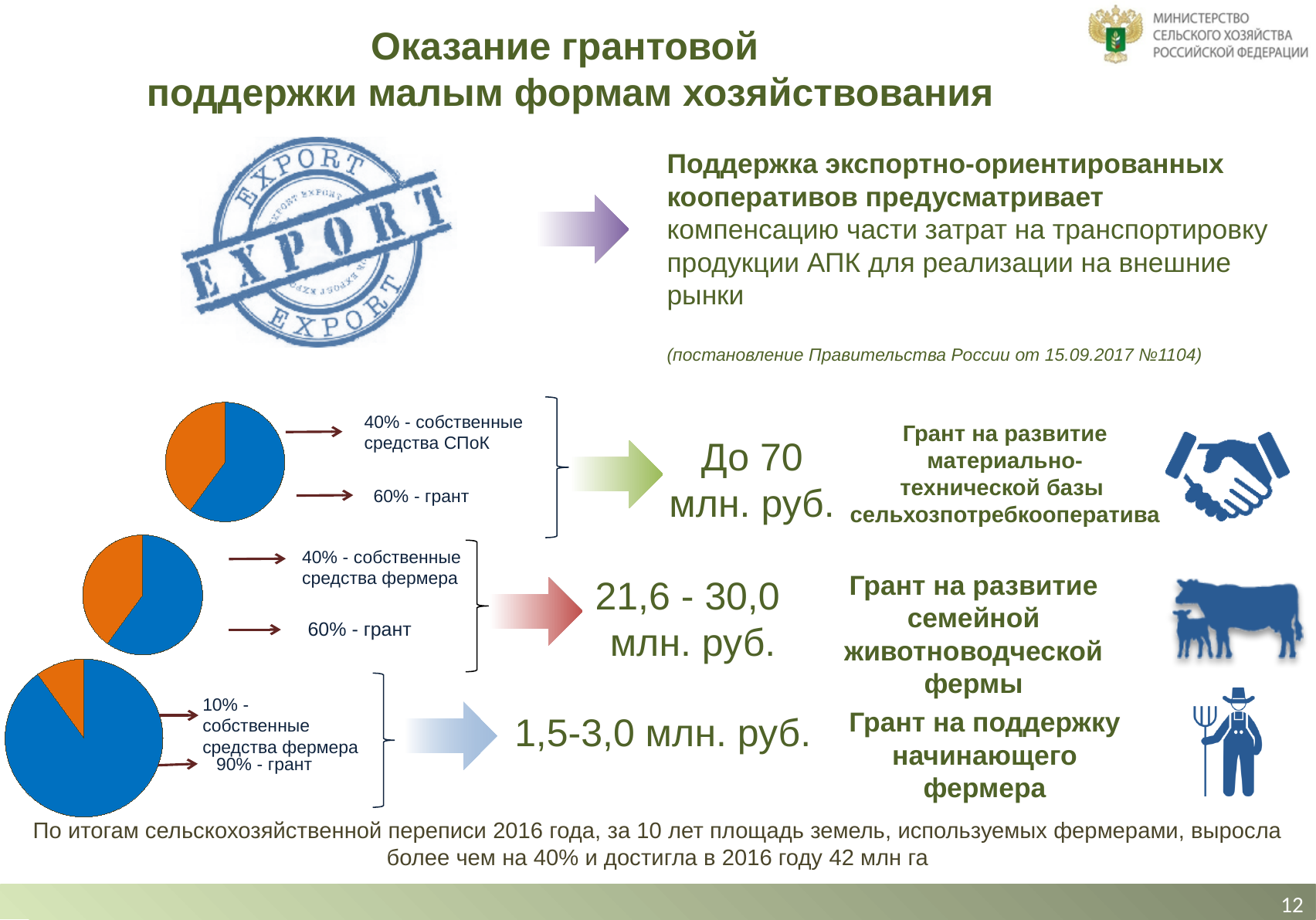
In the top pie chart, what is the difference between the grant share and the SPoK's own funds share? 20% In the bottom pie chart, what share is labelled as the grant (грант)? 90% In the middle pie chart, what share is labelled as the grant (грант)? 60% What kind of chart is the top chart on the left side of the slide? Pie chart In the top pie chart, what share is labelled as own funds of the SPoK (собственные средства СПоК)? 40% In the bottom pie chart, which slice is larger: the grant or the farmer's own funds? Grant (грант) How many slices does each pie chart on the slide have? 2 In the bottom pie chart, what is the difference between the grant share and the farmer's own funds share? 80% How many pie charts are shown on the slide? 3